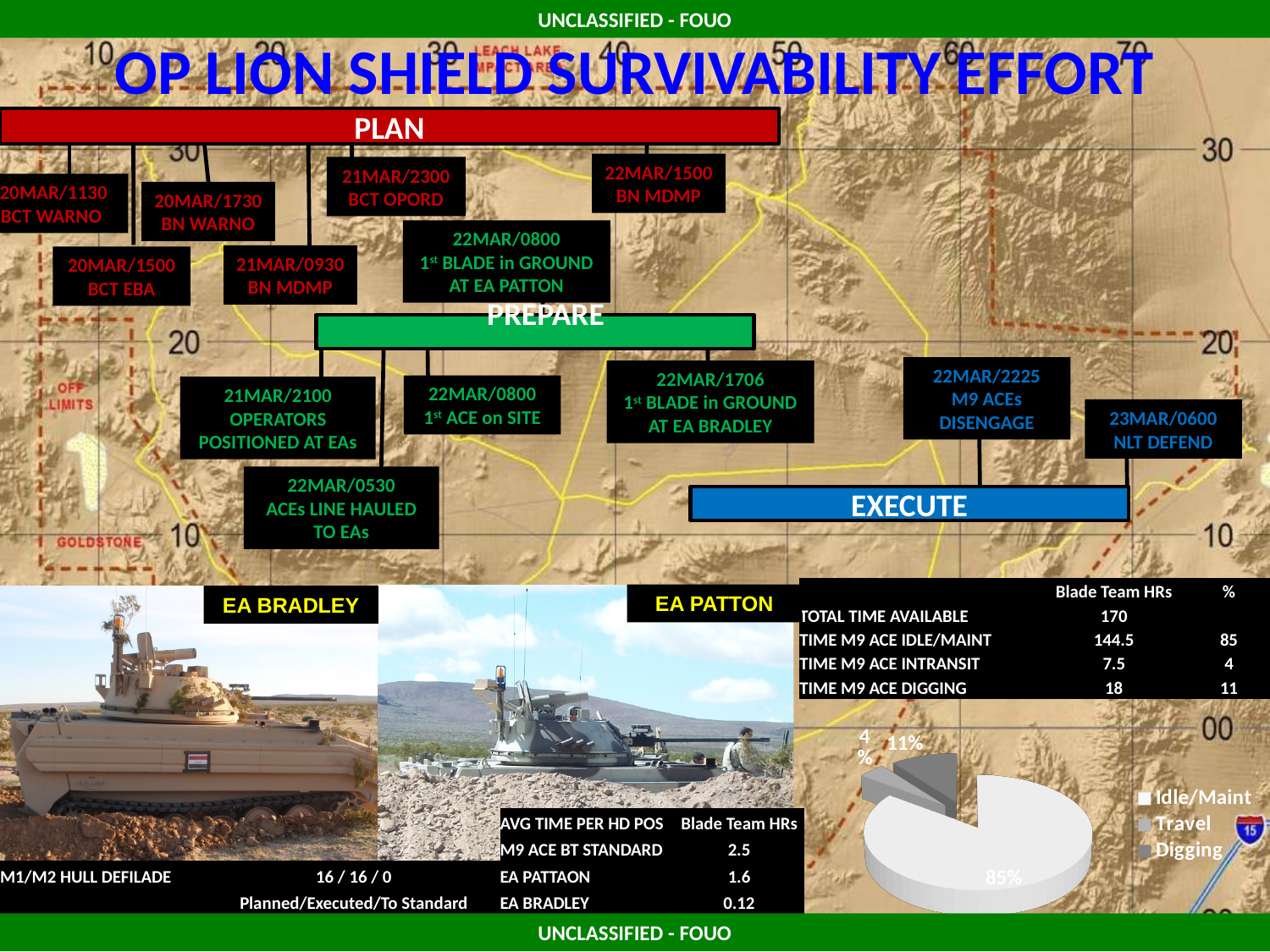
How many slices does the pie chart have? 3 What share of the pie chart is Digging? 11% Which slice of the pie chart is the smallest? Travel What share of the pie chart is Travel? 4% What are the three entries listed in the pie chart's legend, in order? Idle/Maint, Travel, Digging In the pie chart, which is larger, Digging or Travel? Digging What kind of chart is shown in the bottom-right corner of the slide? pie chart Which slice of the pie chart is the largest? Idle/Maint How many entries does the pie chart's legend list? 3 What share of the pie chart is Idle/Maint? 85% In the pie chart, how many percentage points larger is Digging than Travel? 7 percentage points In the pie chart, how many percentage points larger is Idle/Maint than Digging? 74 percentage points